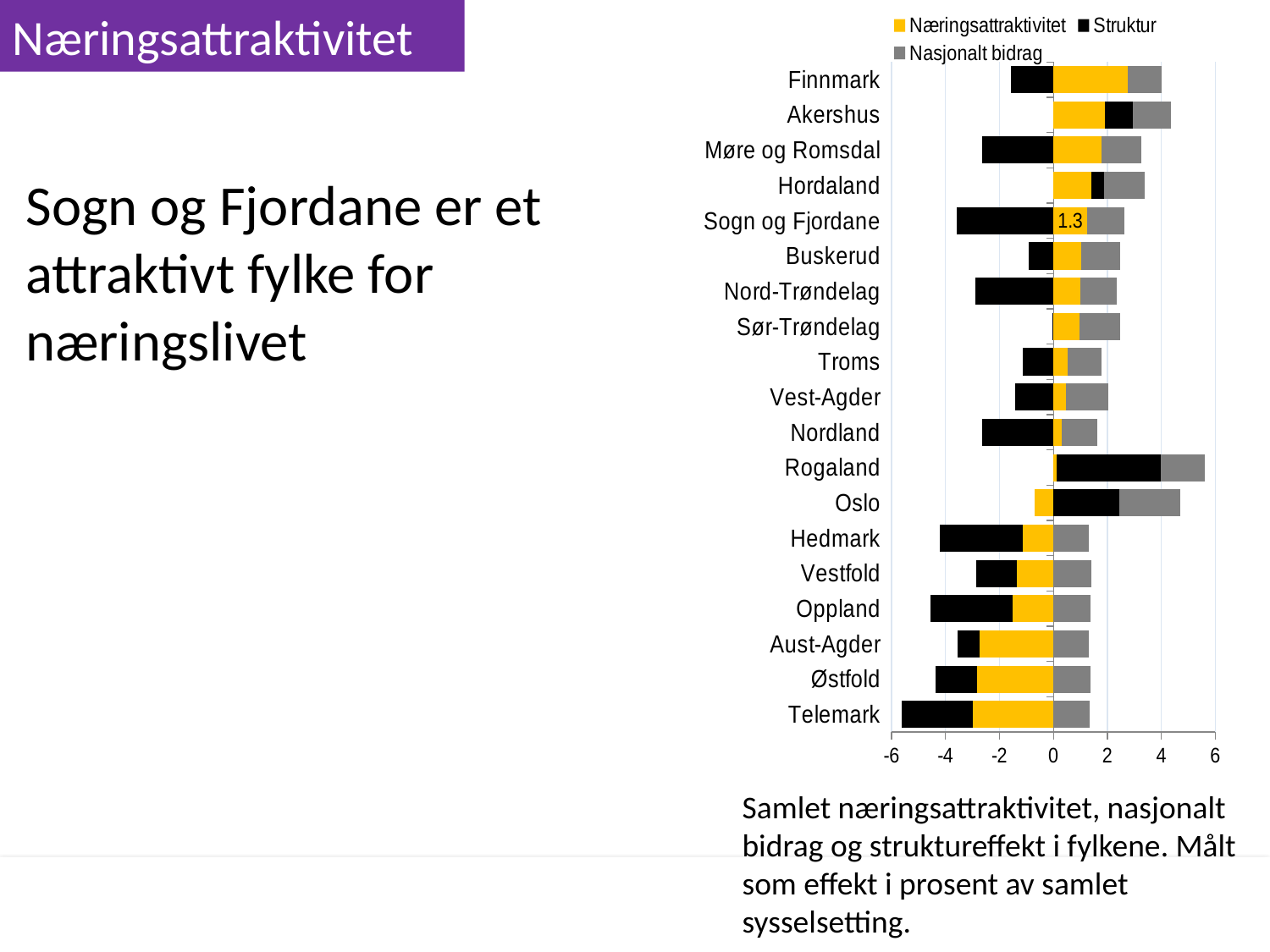
Which county has the highest Struktur value? Rogaland How many series does the legend list? 3 Which county has the highest Næringsattraktivitet value? Finnmark Is the Struktur value for Rogaland greater or less than 2? greater Which has the larger Næringsattraktivitet value, Finnmark or Hordaland? Finnmark How many counties (categories) are plotted in the chart? 19 Is the Næringsattraktivitet value for Finnmark greater or less than 2? greater What is the Næringsattraktivitet value for Sogn og Fjordane? 1.3 What kind of chart is shown on the slide? bar chart What colour represents the Struktur series in the chart? black Is the Struktur value for Telemark greater or less than -2? less Which has the larger Struktur value, Rogaland or Akershus? Rogaland